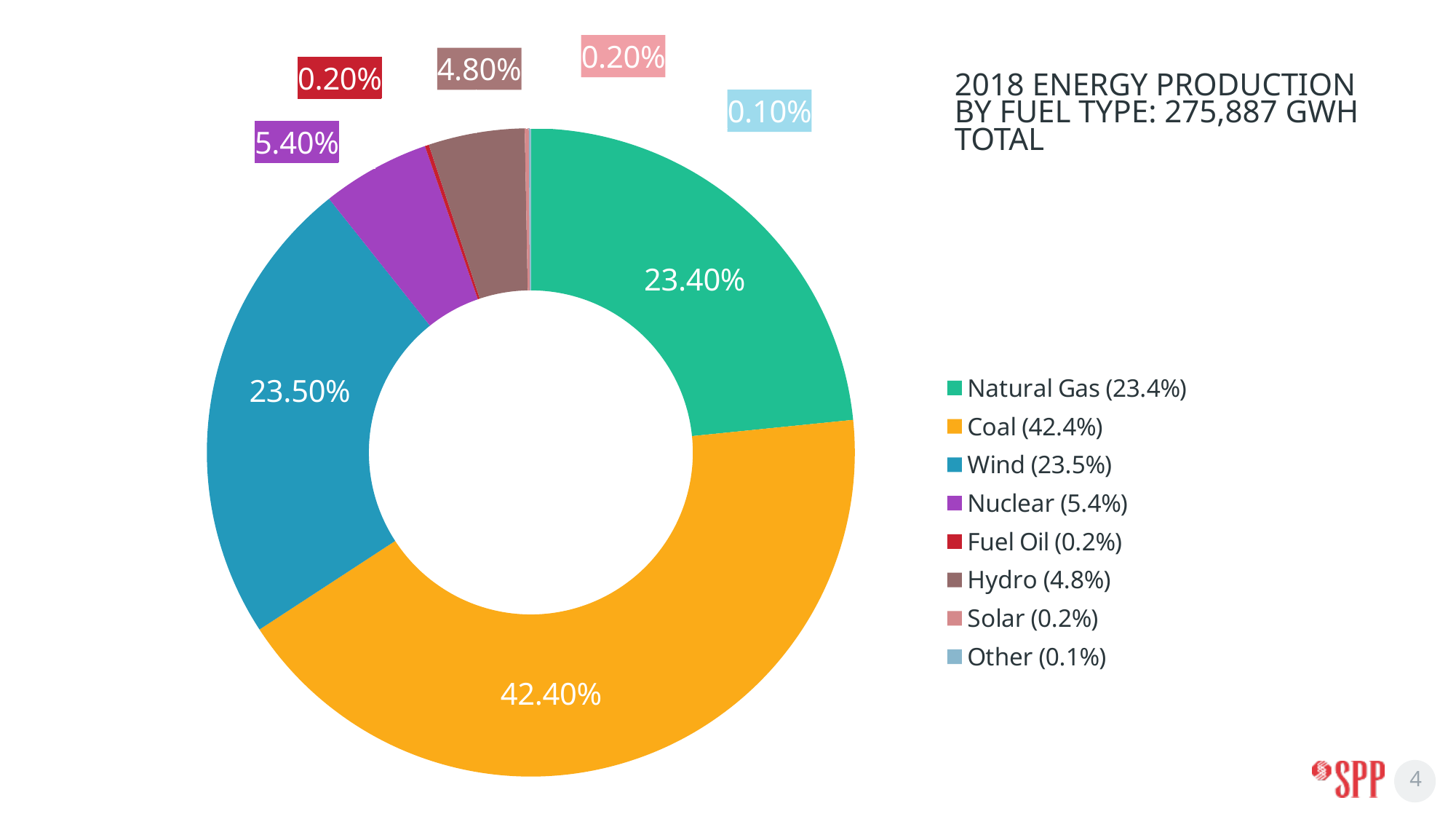
Which is larger, the share for Nuclear or the share for Hydro? Nuclear What is the value shown for Nuclear? 5.40% What is the total energy production stated in the chart title? 275,887 GWH How many fuel types are shown in the chart? 8 What is the difference between the Wind share and the Natural Gas share? 0.10% What kind of chart is shown on the slide? Doughnut chart What is the difference between the Coal share and the Wind share? 18.90% What share of 2018 energy production does Coal account for? 42.40% Which fuel type has the largest share of the pie? Coal Which fuel type has the smallest share of the pie? Other What share does Other have in the chart? 0.10% What percentage of the pie is Hydro? 4.80%